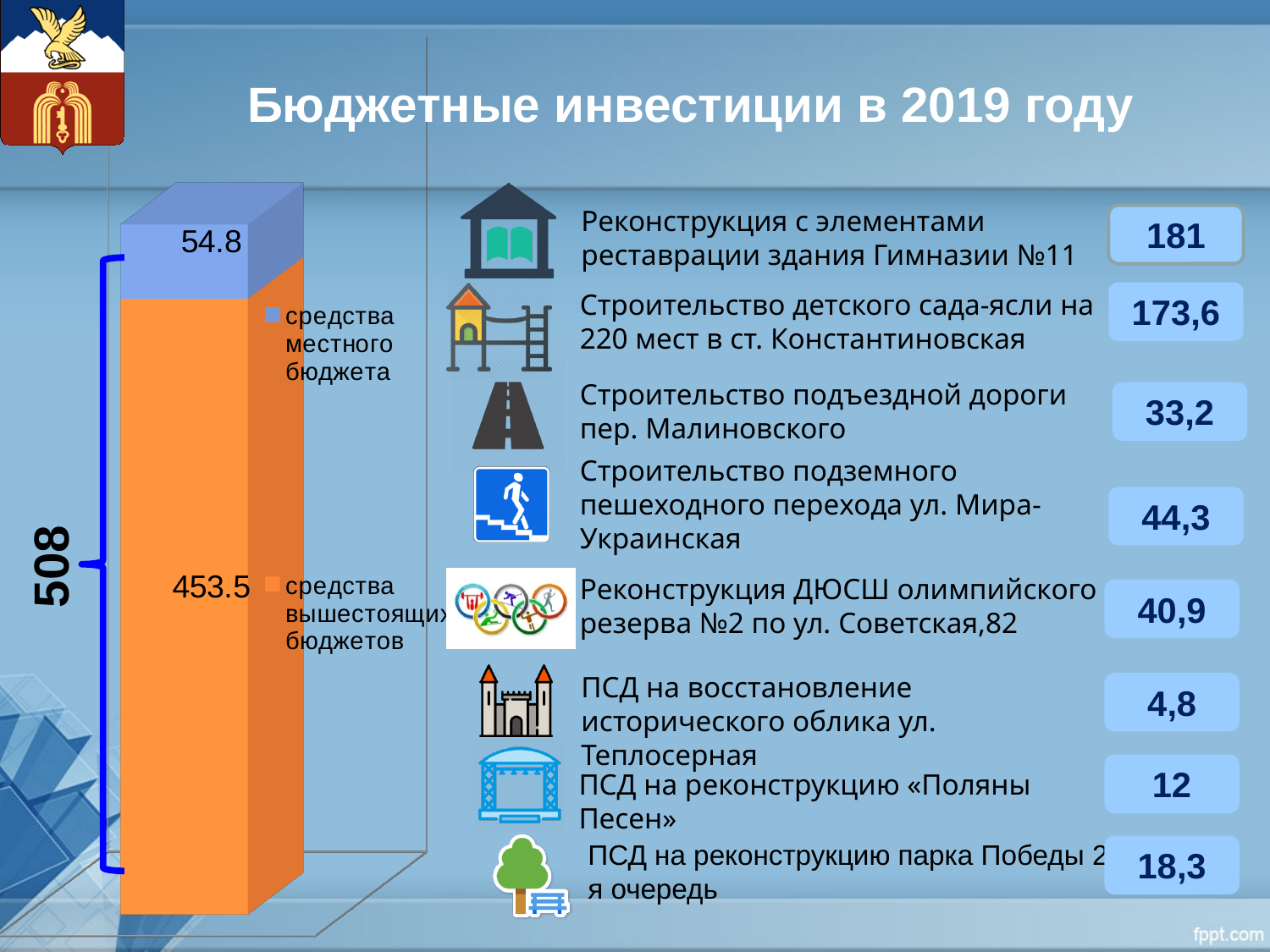
How many series does the chart legend list? 2 What is the value of the 'средства вышестоящих бюджетов' segment in the stacked bar? 453.5 What is the difference between the 'средства вышестоящих бюджетов' segment and the 'средства местного бюджета' segment? 398.7 Which segment of the stacked bar is larger: 'средства местного бюджета' or 'средства вышестоящих бюджетов'? средства вышестоящих бюджетов What kind of chart is shown on the left of the slide? stacked bar chart Which colour represents 'средства вышестоящих бюджетов' in the chart? orange Which colour represents 'средства местного бюджета' in the chart? blue How many bars does the chart contain? 1 What is the value of the 'средства местного бюджета' segment in the stacked bar? 54.8 What is the total of the stacked bar shown on the slide? 508 Which segment of the stacked bar has the smallest value? средства местного бюджета